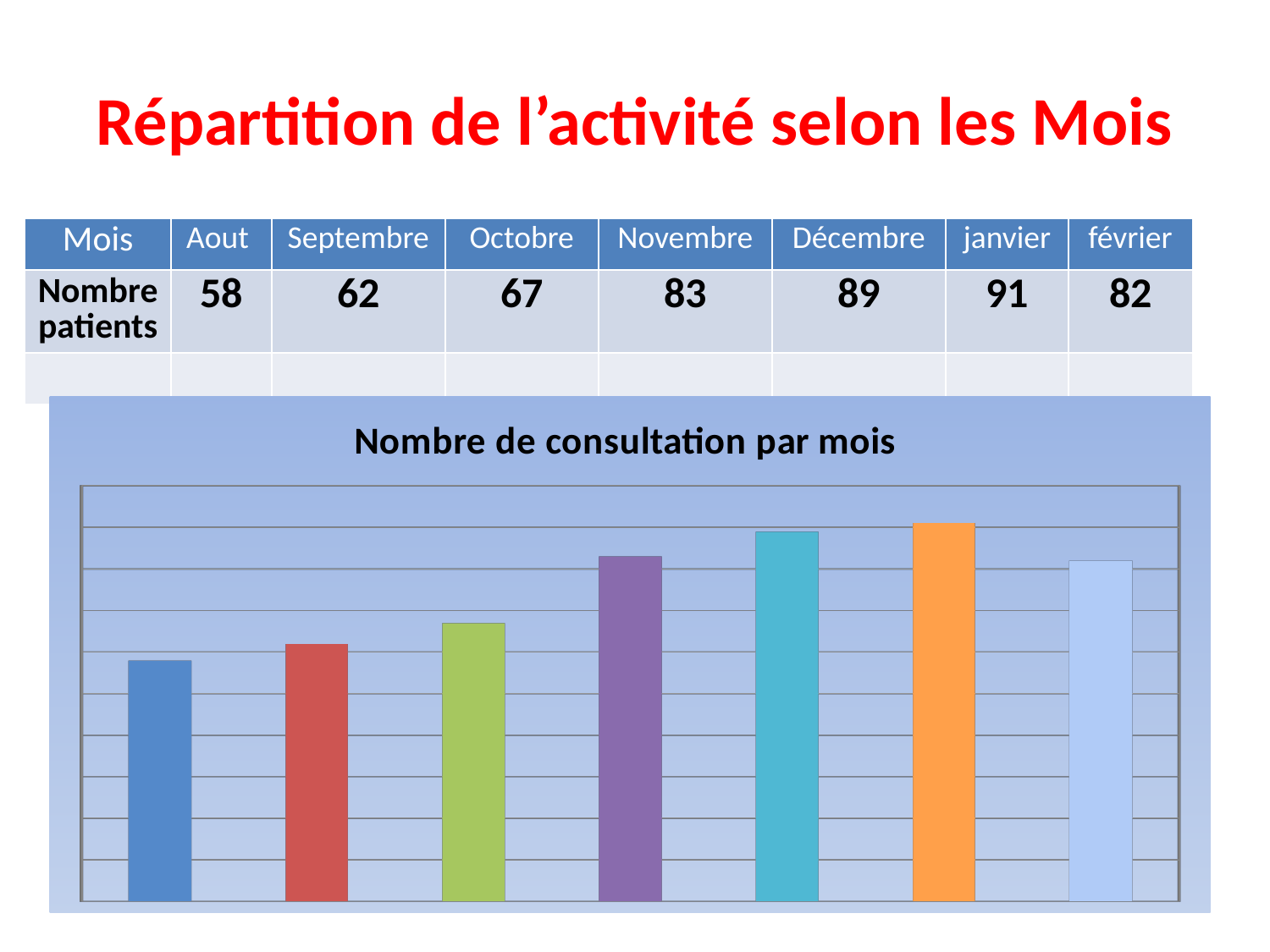
What colour is the tallest bar in the chart? orange According to the table above the chart, which month has the highest number of patients? janvier Which bar in the chart is the tallest, counting from the left? the sixth bar Which bar in the chart is the shortest, counting from the left? the first bar What kind of chart is shown on the slide? bar chart What is the title of the chart? Nombre de consultation par mois Do the bars rise or fall from the first bar to the sixth bar? rise How many bars does the chart contain? 7 According to the table above the chart, which month has the lowest number of patients? Aout According to the table above the chart, how many patients were there in Novembre? 83 Is the fifth bar from the left taller or shorter than the seventh bar? taller According to the table above the chart, what is the difference in number of patients between janvier and Aout? 33